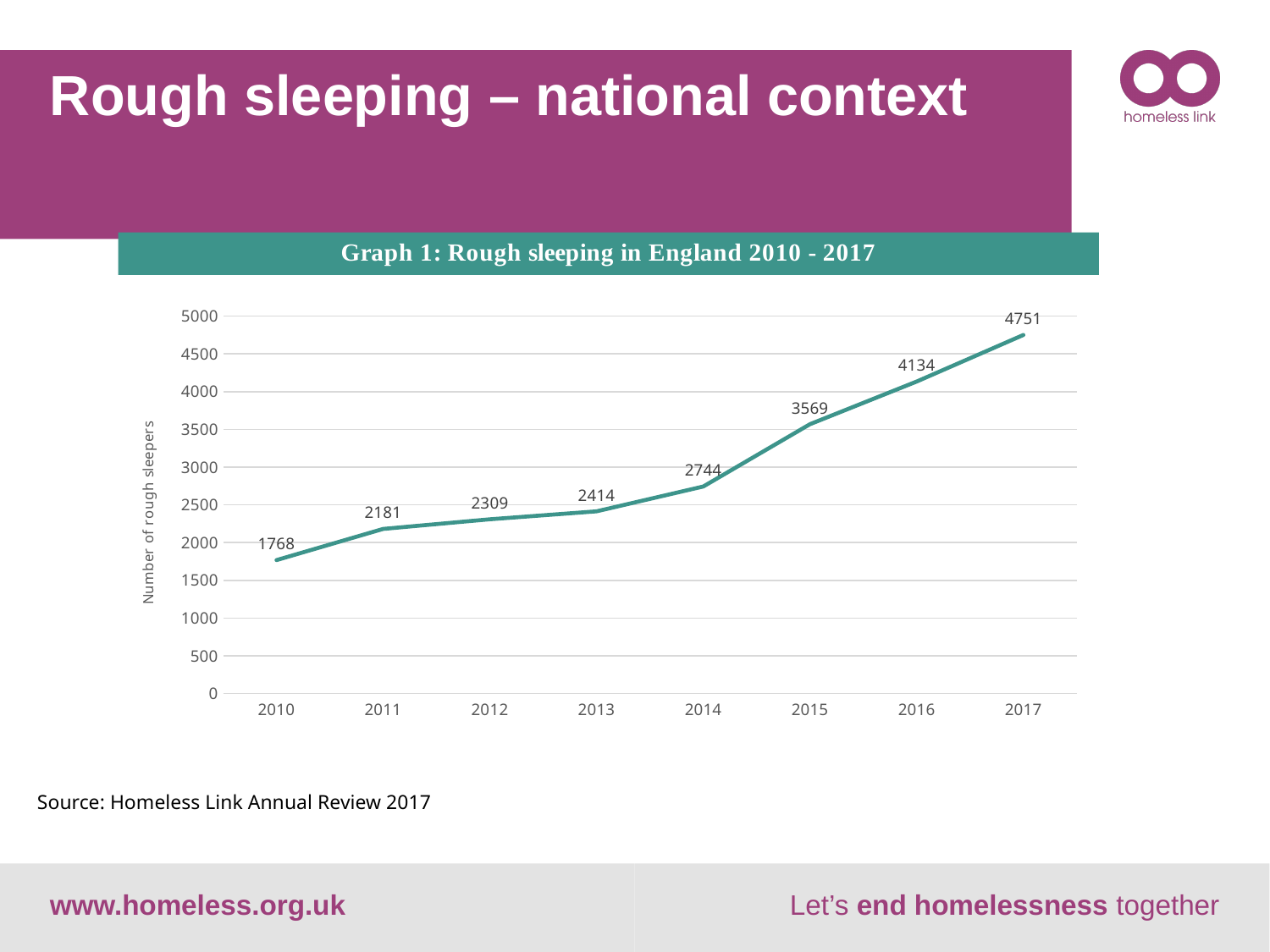
Which year has more rough sleepers, 2012 or 2013? 2013 What is the number of rough sleepers in 2014? 2744 Which year has the highest number of rough sleepers? 2017 Which year has the lowest number of rough sleepers? 2010 How many years are plotted on the chart? 8 What is the number of rough sleepers in 2010? 1768 What kind of chart is shown on the slide? Line chart Is the number of rough sleepers in 2015 greater or less than 3500? greater What is the number of rough sleepers in 2017? 4751 What is the difference in the number of rough sleepers between 2017 and 2010? 2983 Does the number of rough sleepers rise or fall from 2010 to 2017? Rise What is the difference in the number of rough sleepers between 2016 and 2015? 565